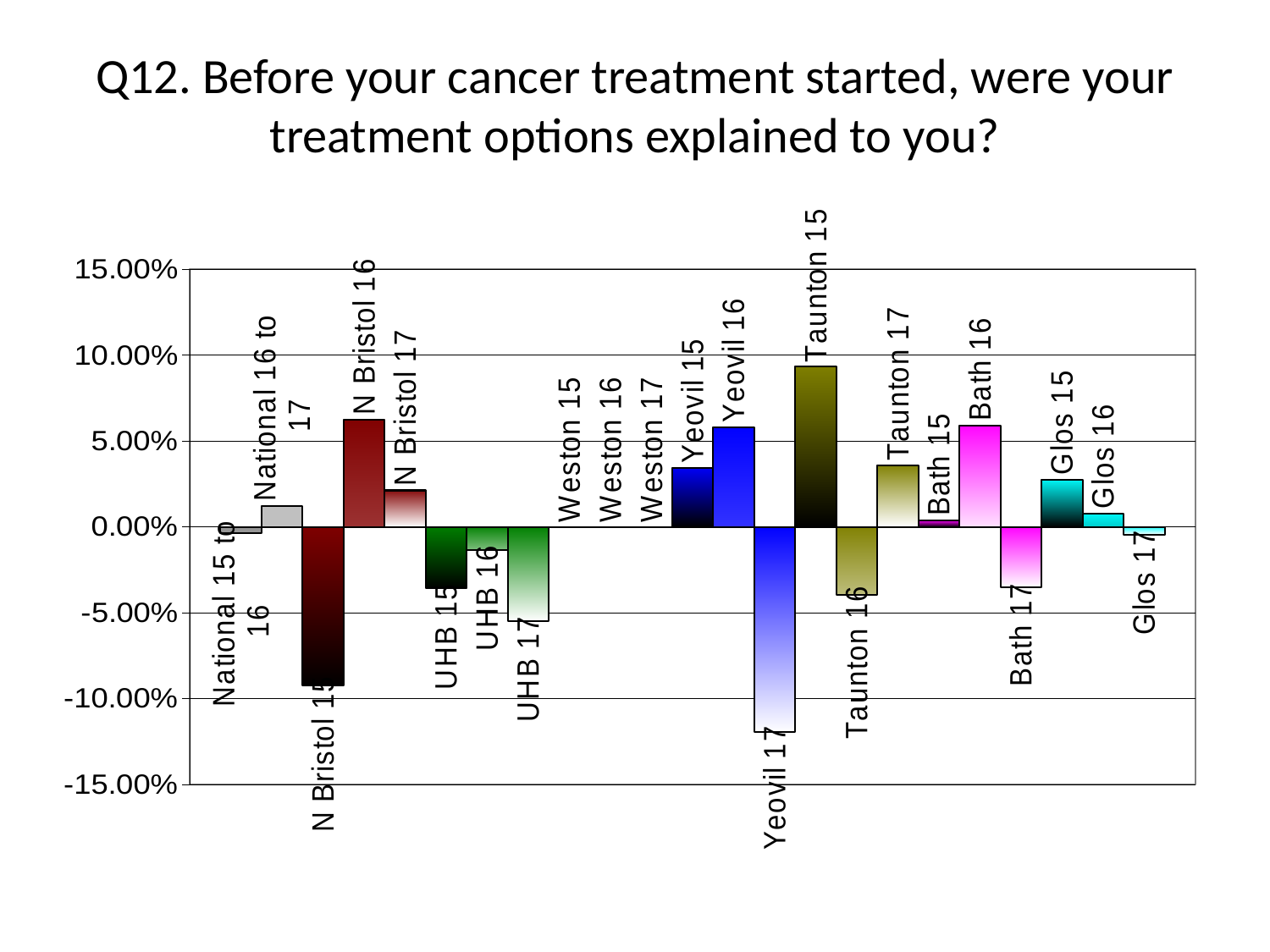
What kind of chart is shown on the slide? bar chart Which is larger, the value for N Bristol 16 or the value for N Bristol 17? N Bristol 16 Is the value for N Bristol 16 greater or less than 5.00%? greater Which is larger, the value for Glos 15 or the value for Glos 16? Glos 15 Which category has the lowest value? Yeovil 17 How many categories are plotted on the chart? 23 Is the value for N Bristol 15 greater or less than -5.00%? less Is the value for UHB 17 greater or less than -5.00%? less Which category has the highest value? Taunton 15 What is the title of the chart? Q12. Before your cancer treatment started, were your treatment options explained to you?